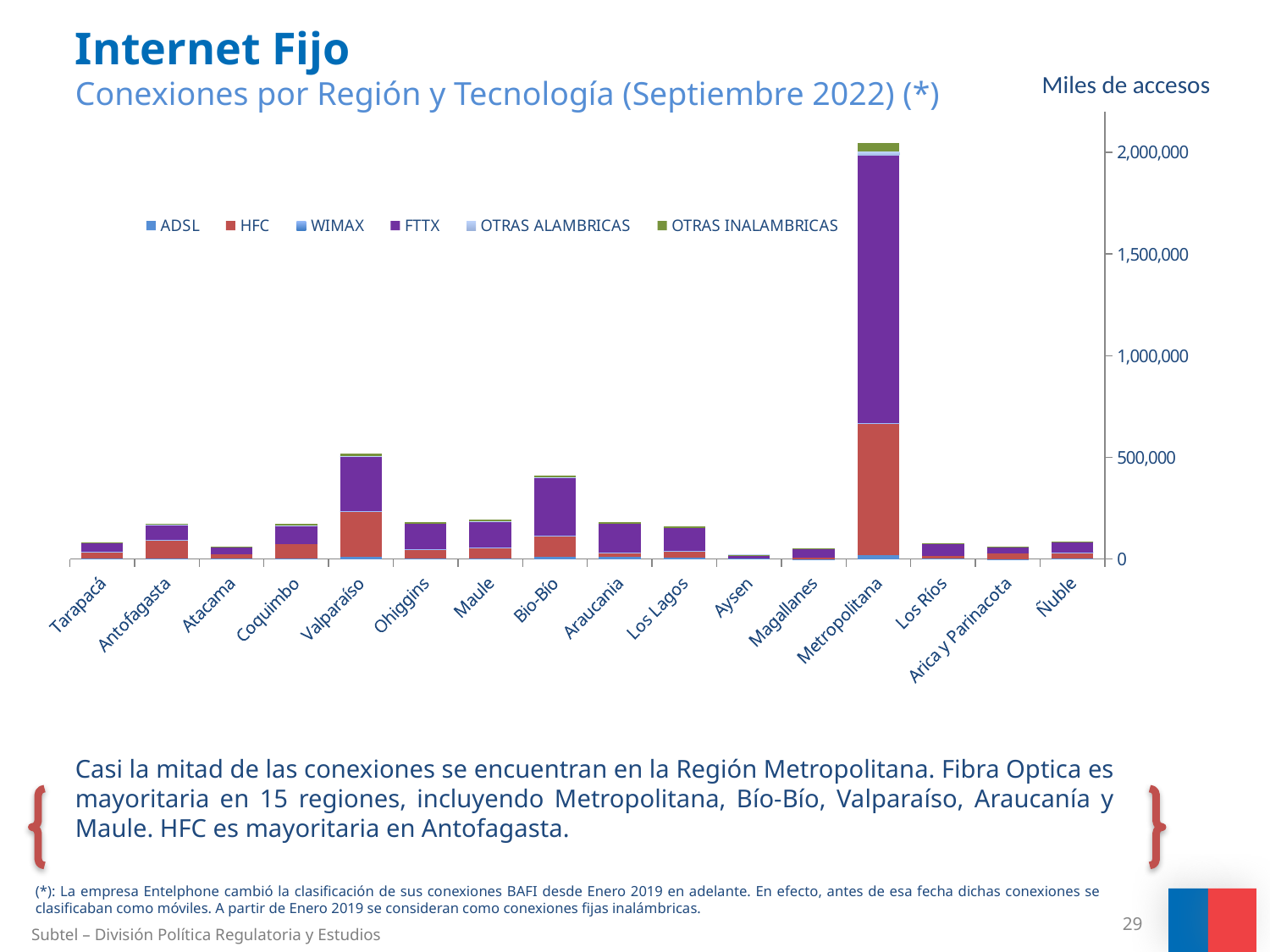
What is the subtitle of the chart? Conexiones por Región y Tecnología (Septiembre 2022) (*) Is the total value for Bío-Bío greater or less than 500,000? less Which region has more total connections, Antofagasta or Atacama? Antofagasta Which region has the highest total number of connections? Metropolitana How many series does the chart's legend list? 6 Which region has more total connections, Valparaíso or Bío-Bío? Valparaíso How many regions are shown along the x axis of the chart? 16 Is the total value for Metropolitana greater or less than 1,500,000? greater Which technology series is shown in purple in the legend? FTTX What kind of chart is shown on the slide? Stacked bar chart Which region has the lowest total number of connections? Aysen Is the total value for Coquimbo greater or less than 500,000? less